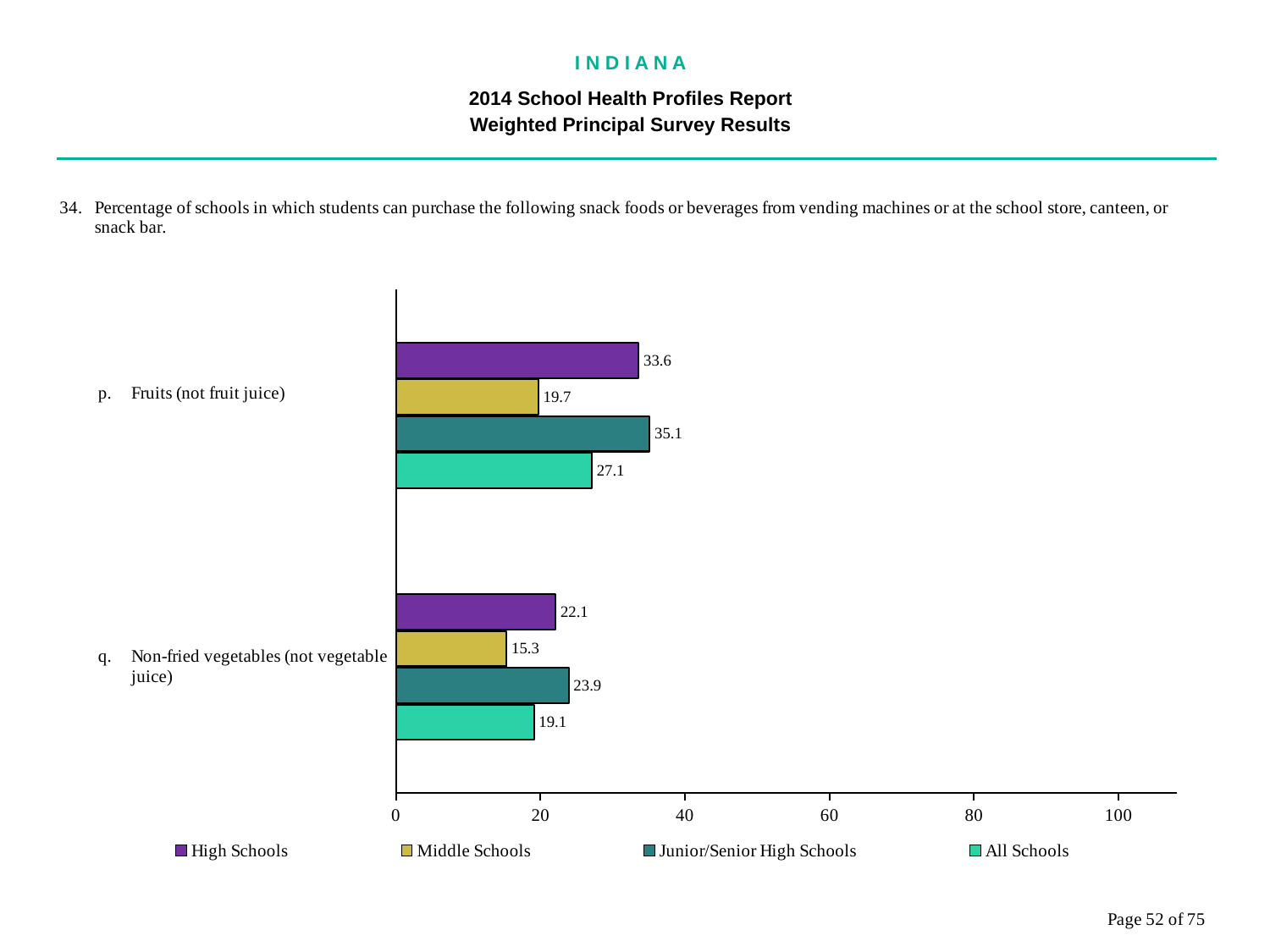
What is the difference between the High Schools values for fruits and for non-fried vegetables? 11.5 Which school type has the lowest value for non-fried vegetables (not vegetable juice)? Middle Schools What is the difference between the Junior/Senior High Schools and Middle Schools values for fruits (not fruit juice)? 15.4 Is the Junior/Senior High Schools value for non-fried vegetables greater or less than 40? less How many series does the legend list? 4 What is the All Schools value for fruits (not fruit juice)? 27.1 What is the value for Middle Schools for non-fried vegetables (not vegetable juice)? 15.3 Which school type has the highest value for fruits (not fruit juice)? Junior/Senior High Schools What kind of chart is shown on the slide? Bar chart Which is larger: the All Schools value for fruits (not fruit juice) or for non-fried vegetables (not vegetable juice)? Fruits (not fruit juice) What colour are the bars for All Schools? Light green What percentage of High Schools allow students to purchase fruits (not fruit juice)? 33.6